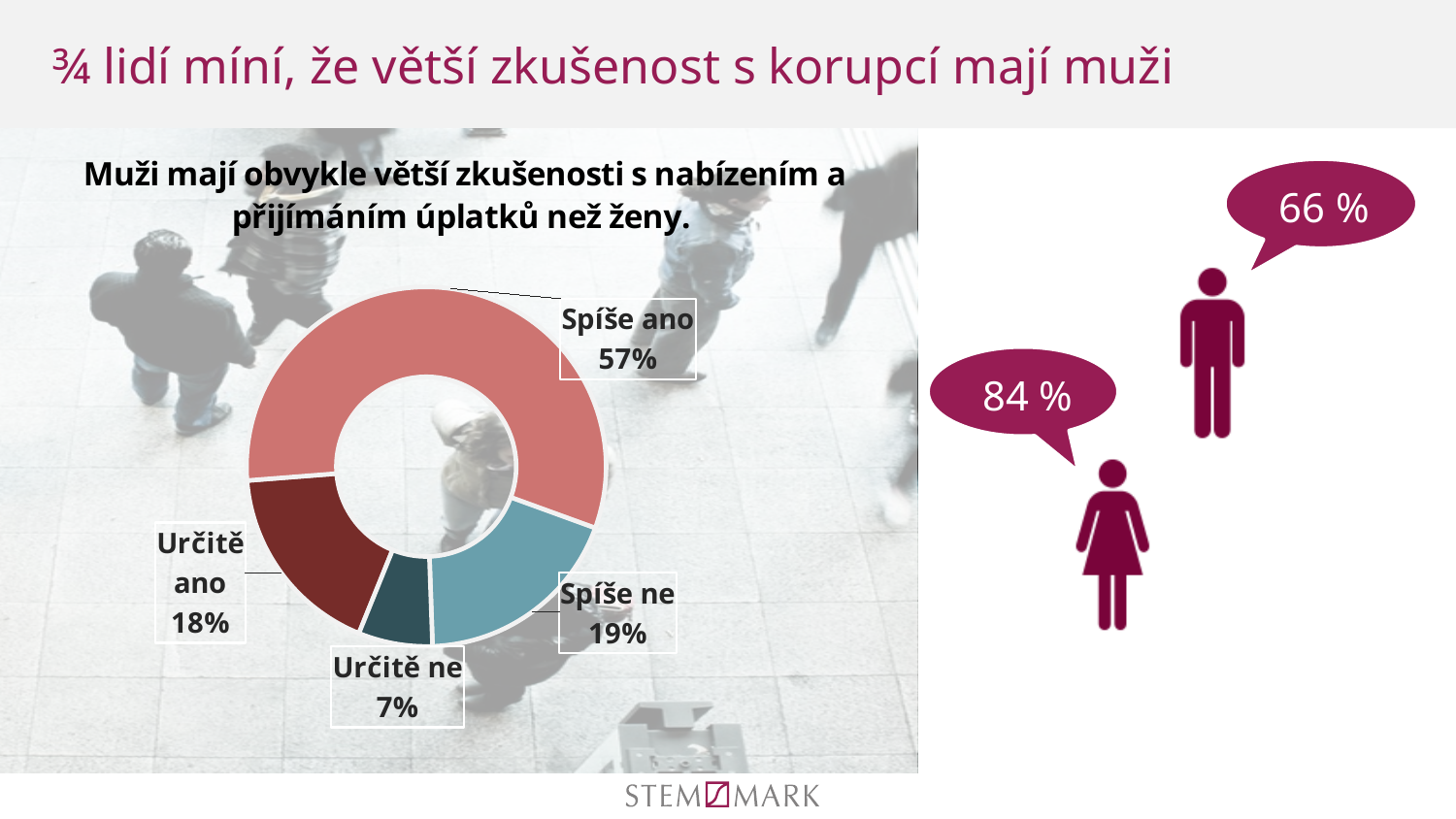
What is the combined share of "Spíše ano" and "Určitě ano" in the donut chart? 75% What is the value for "Spíše ano" in the donut chart? 57% What kind of chart is shown on the slide? Donut (pie) chart Which category has the smallest share in the donut chart? Určitě ne What is the value for "Určitě ne" in the donut chart? 7% What is the difference between the "Spíše ano" and "Spíše ne" shares in the donut chart? 38 percentage points What is the value for "Určitě ano" in the donut chart? 18% What statement is the donut chart asking respondents to agree or disagree with? Muži mají obvykle větší zkušenosti s nabízením a přijímáním úplatků než ženy. How many categories are shown in the donut chart? 4 Which is larger in the donut chart, "Určitě ano" or "Určitě ne"? Určitě ano Which category has the largest share in the donut chart? Spíše ano What is the value for "Spíše ne" in the donut chart? 19%